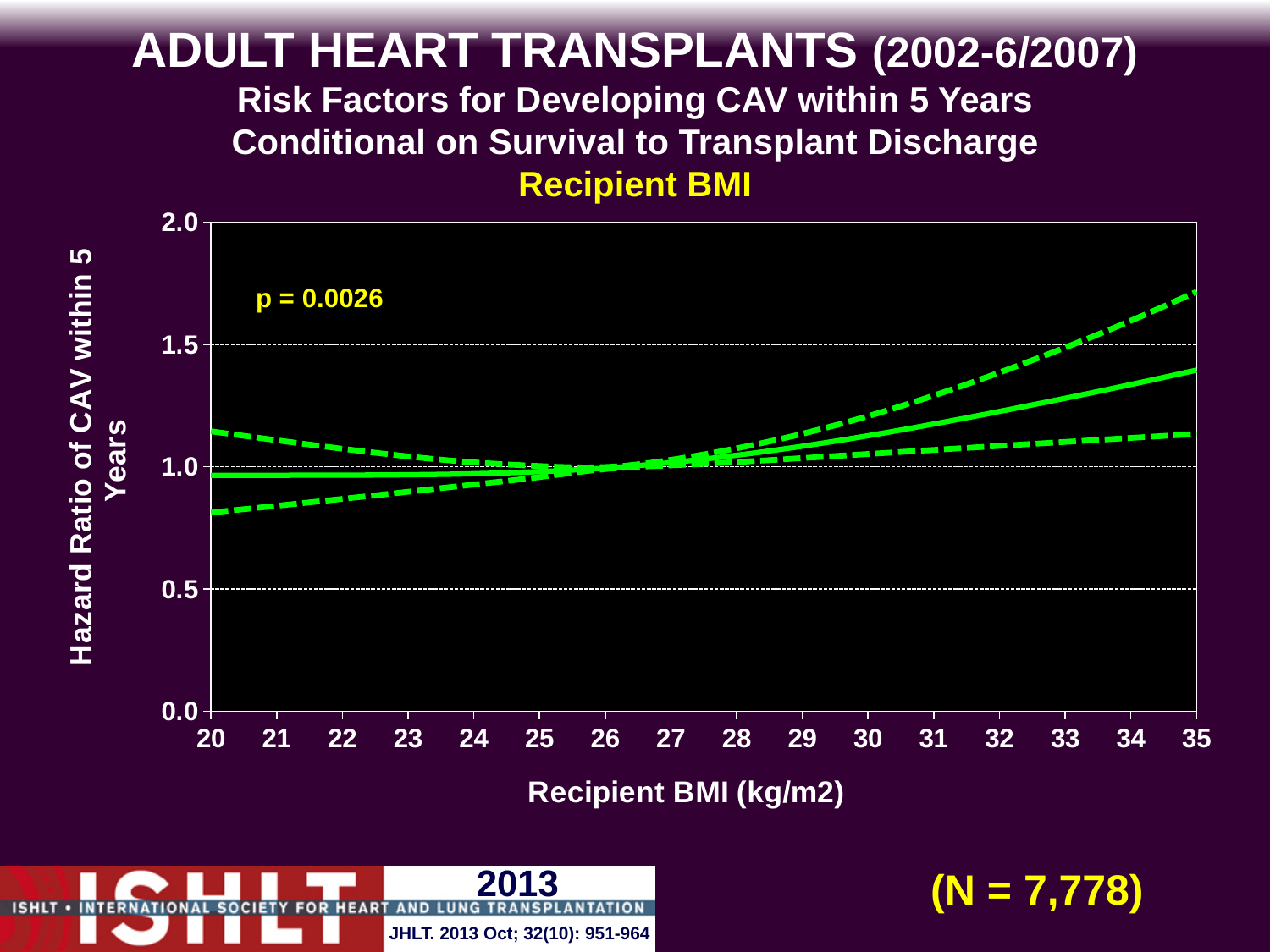
What is the label of the x axis? Recipient BMI (kg/m2) Is the value of the solid hazard ratio line at a Recipient BMI of 30 greater or less than 1.5? less What is the lowest Recipient BMI value shown on the x axis? 20 What is the p-value printed on the chart? p = 0.0026 What kind of chart is shown on the slide? line chart How many lines are plotted on the chart? 3 How many tick labels are shown on the Recipient BMI x axis? 16 What is the highest value shown on the y axis? 2.0 Does the solid hazard ratio line rise or fall as Recipient BMI increases from 26 to 35? rise Is the value of the solid hazard ratio line at a Recipient BMI of 35 greater or less than 1.0? greater Is the value of the lower dashed line at a Recipient BMI of 20 greater or less than 1.0? less